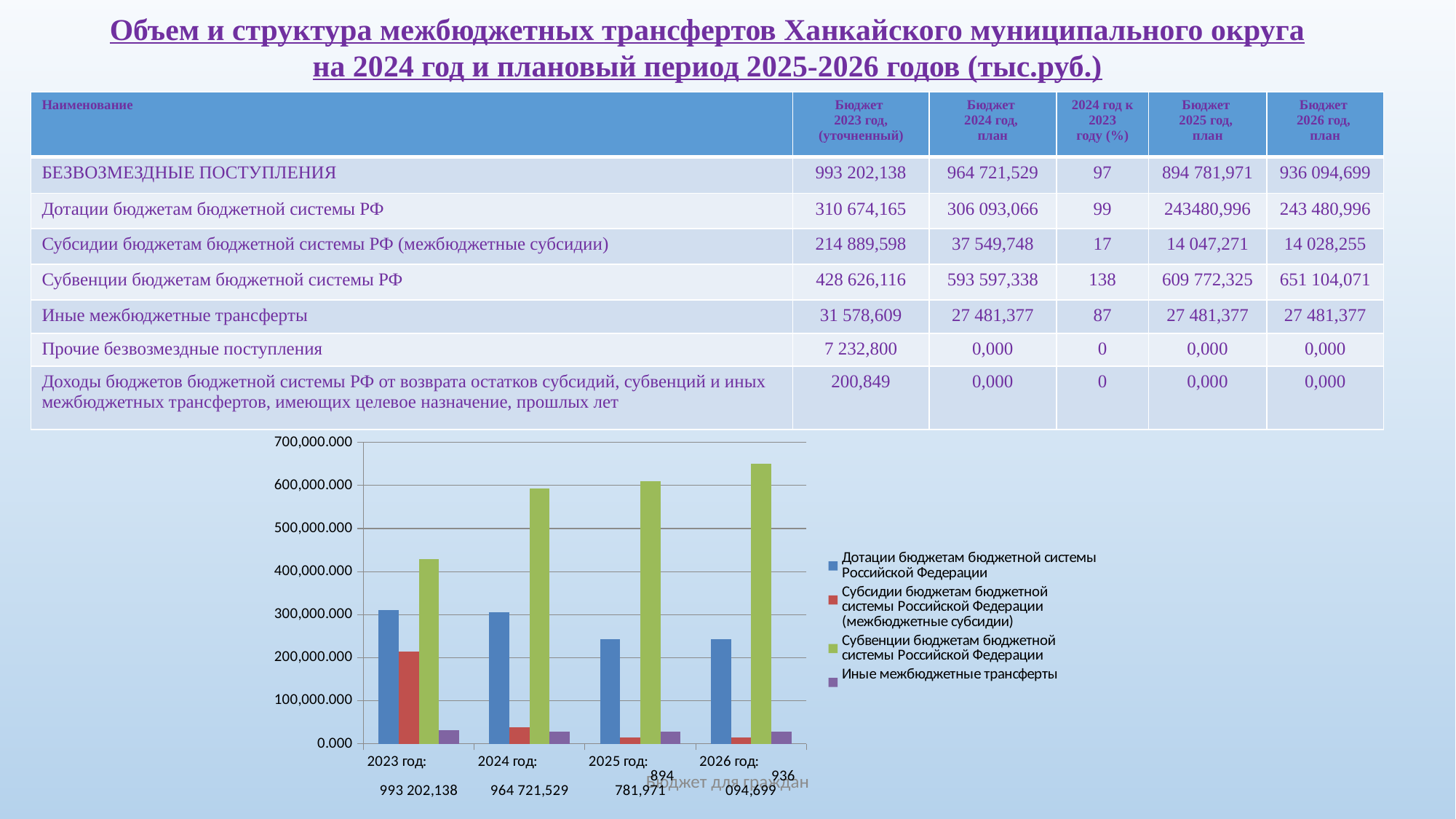
How many series does the chart legend list? 4 What kind of chart is shown on the slide? bar chart In 2023, which is larger: Дотации бюджетам бюджетной системы Российской Федерации or Субсидии бюджетам бюджетной системы Российской Федерации (межбюджетные субсидии)? Дотации бюджетам бюджетной системы Российской Федерации Do the bars for Дотации бюджетам бюджетной системы Российской Федерации rise or fall from 2023 to 2026? fall Is the value for Субвенции бюджетам бюджетной системы Российской Федерации in 2023 greater or less than 400,000.000? greater Do the bars for Субвенции бюджетам бюджетной системы Российской Федерации rise or fall from 2023 to 2026? rise How many year categories are shown on the x axis of the chart? 4 Which year has the highest bar for Субвенции бюджетам бюджетной системы Российской Федерации? 2026 год According to the table, what is the planned 2024 value for Субвенции бюджетам бюджетной системы РФ? 593 597,338 Is the value for Субвенции бюджетам бюджетной системы Российской Федерации in 2026 greater or less than 600,000.000? greater Which colour represents Иные межбюджетные трансферты in the chart legend? purple Is the value for Субсидии бюджетам бюджетной системы Российской Федерации (межбюджетные субсидии) in 2024 greater or less than 100,000.000? less